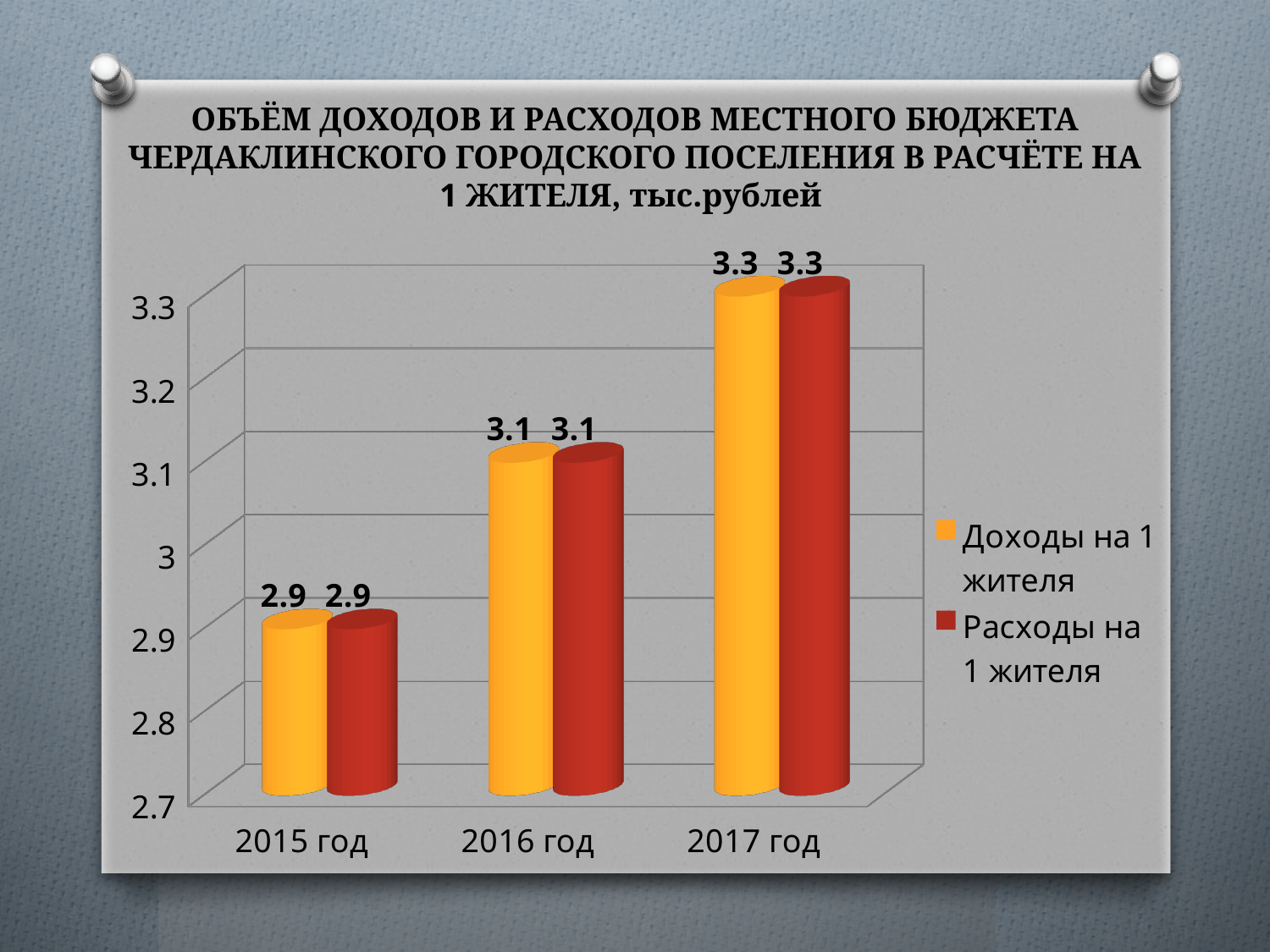
What is the value of "Доходы на 1 жителя" for 2016 год? 3.1 Which year has the lowest value for "Доходы на 1 жителя"? 2015 год What is the value of "Доходы на 1 жителя" for 2015 год? 2.9 Which is larger: "Расходы на 1 жителя" in 2016 год or in 2015 год? 2016 год Which year has the highest value for "Расходы на 1 жителя"? 2017 год Do the values for "Доходы на 1 жителя" rise or fall from 2015 год to 2017 год? Rise What is the value of "Расходы на 1 жителя" for 2017 год? 3.3 What is the difference between "Доходы на 1 жителя" in 2017 год and in 2015 год? 0.4 How many years are shown on the x axis? 3 How many series does the legend list? 2 Which colour represents "Расходы на 1 жителя" in the legend? Red What kind of chart is shown on the slide? Bar chart